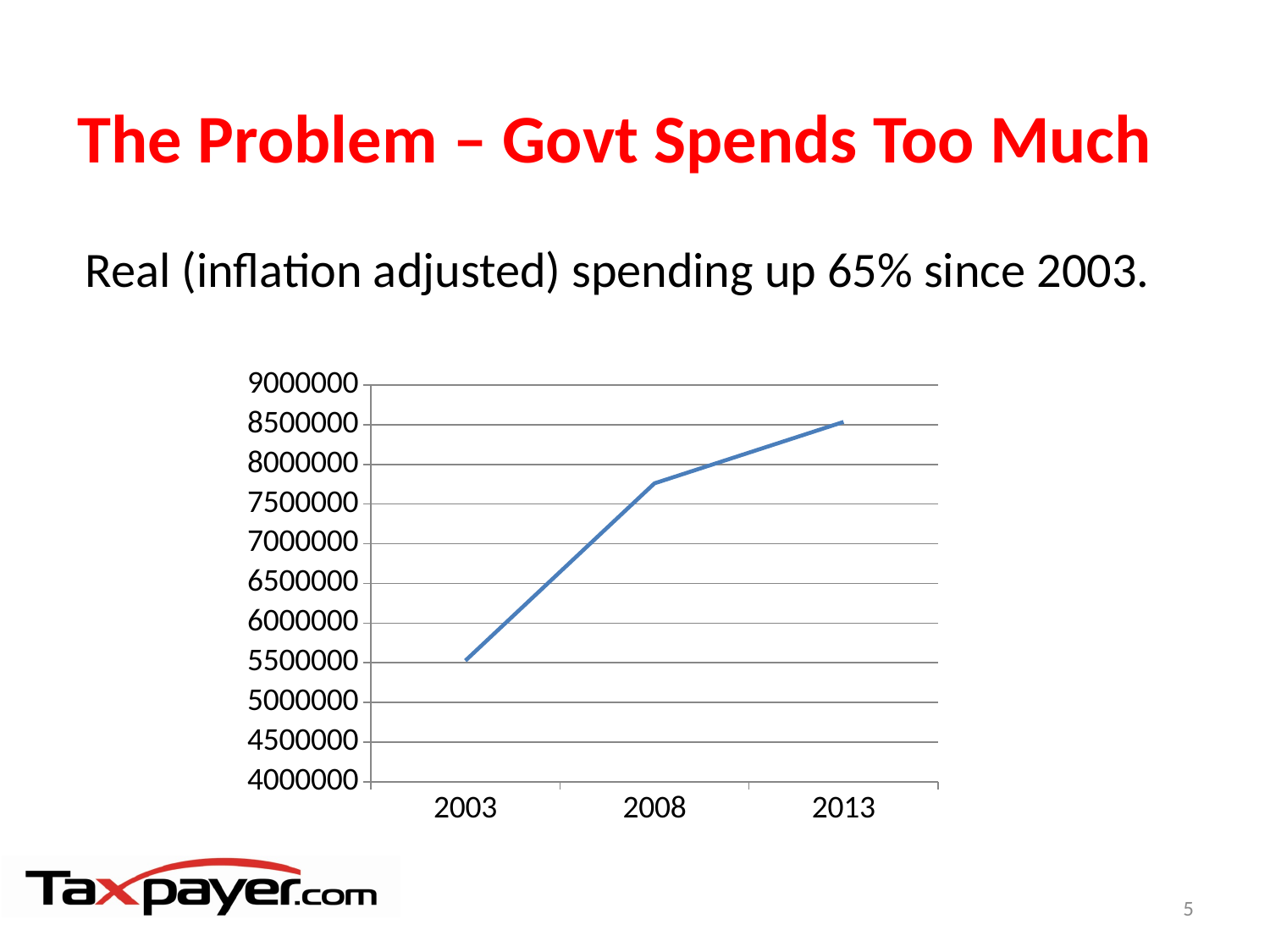
What kind of chart is shown on the slide? line chart Which is larger, the value for 2008 or the value for 2013? 2013 Which years are shown on the x axis of the chart? 2003, 2008, 2013 How many data points are plotted on the line chart? 3 Is the value for 2008 greater or less than 7000000? greater Do the values rise or fall from 2003 to 2013? rise Which year has the highest value on the chart? 2013 Is the value for 2008 greater or less than 8000000? less What is the highest value shown on the y axis of the chart? 9000000 Which year has the lowest value on the chart? 2003 Is the value for 2013 greater or less than 8000000? greater